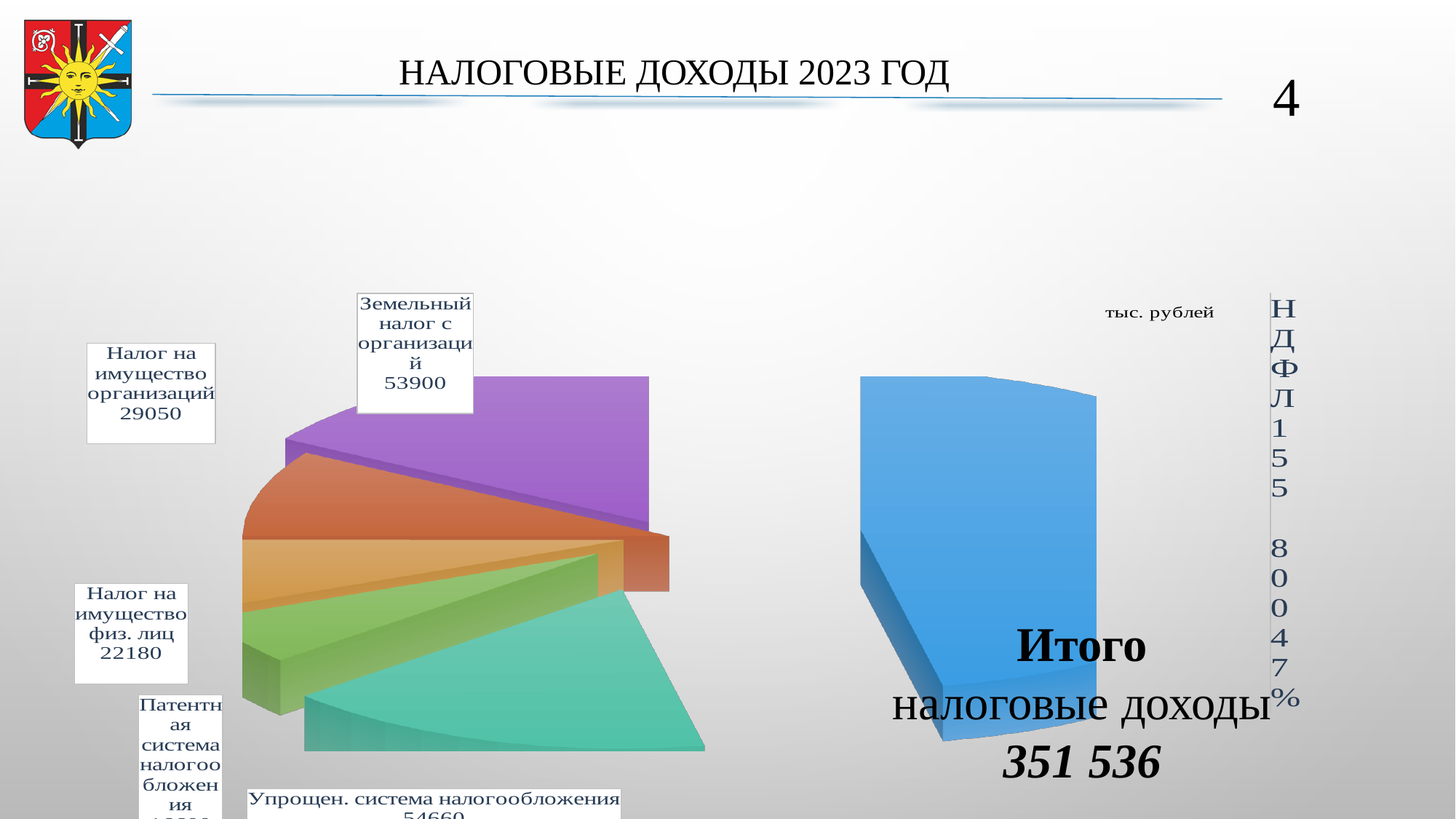
What share of the pie does НДФЛ account for? 47% What is the difference between Земельный налог с организаций and Налог на имущество организаций? 24850 What is the value shown for Налог на имущество организаций? 29050 What is the value shown for Земельный налог с организаций? 53900 What is the value shown for НДФЛ? 155 800 What is the value shown for Налог на имущество физ. лиц? 22180 What is the difference between Налог на имущество организаций and Налог на имущество физ. лиц? 6870 Which category has the largest slice of the pie? НДФЛ Which is larger, Земельный налог с организаций or Налог на имущество организаций? Земельный налог с организаций What is the total of налоговые доходы shown on the slide? 351 536 What kind of chart is shown on the slide? Pie chart How many slices does the pie chart have? 6